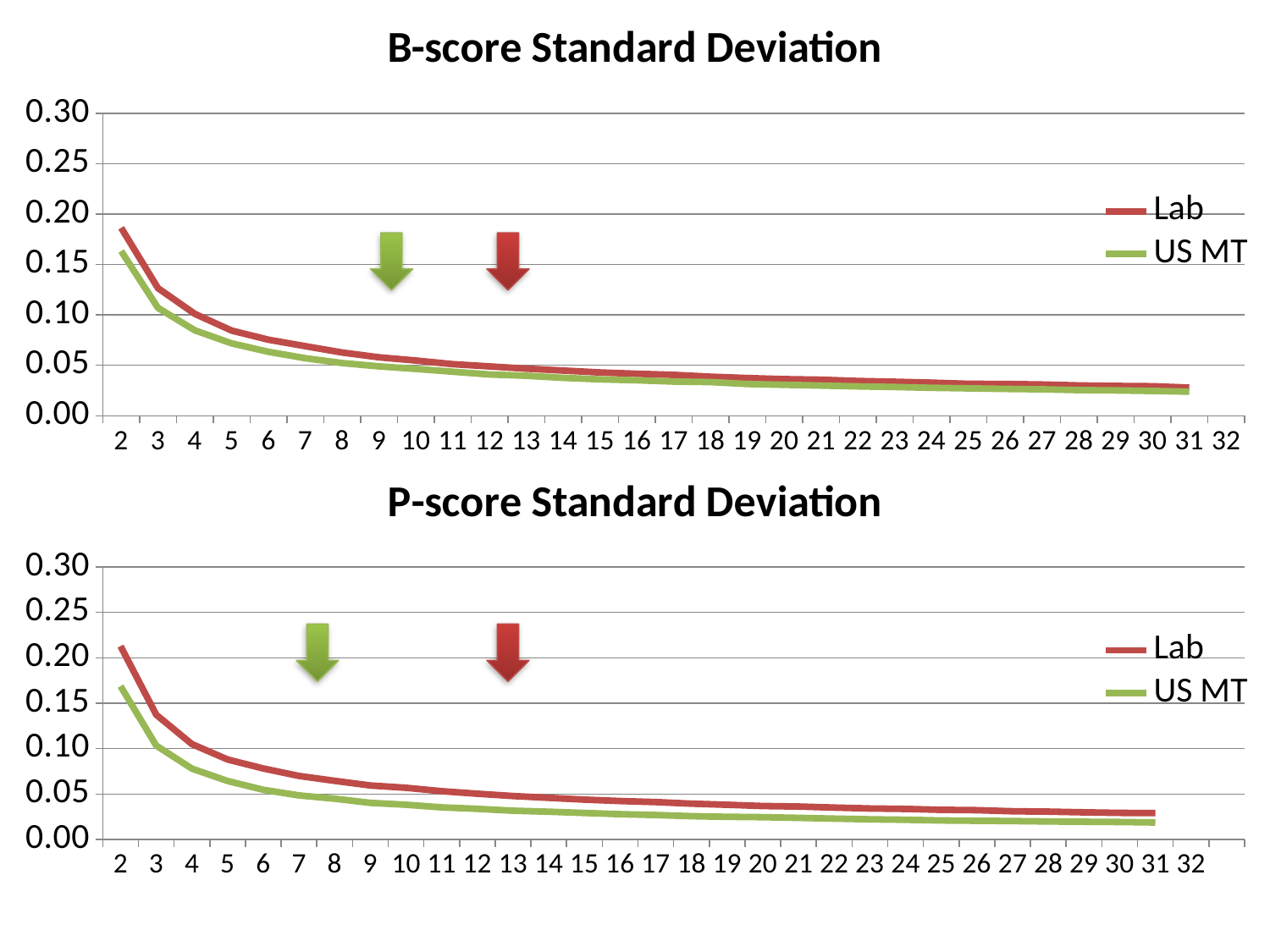
What colour is the US MT line in the B-score Standard Deviation chart? green In the B-score Standard Deviation chart, which series has the higher value at x = 2, Lab or US MT? Lab In the P-score Standard Deviation chart, which series has the higher value at x = 5, Lab or US MT? Lab In the P-score Standard Deviation chart, is the Lab value at x = 2 greater or less than 0.15? greater How many series does the legend of the P-score Standard Deviation chart list? 2 In the B-score Standard Deviation chart, is the Lab value at x = 31 greater or less than 0.05? less In the P-score Standard Deviation chart, do the US MT values rise or fall as the x axis increases? fall What kind of chart is the B-score Standard Deviation chart? line chart In the B-score Standard Deviation chart, is the Lab value at x = 2 greater or less than 0.15? greater In the B-score Standard Deviation chart, do the Lab values rise or fall as the x axis increases? fall